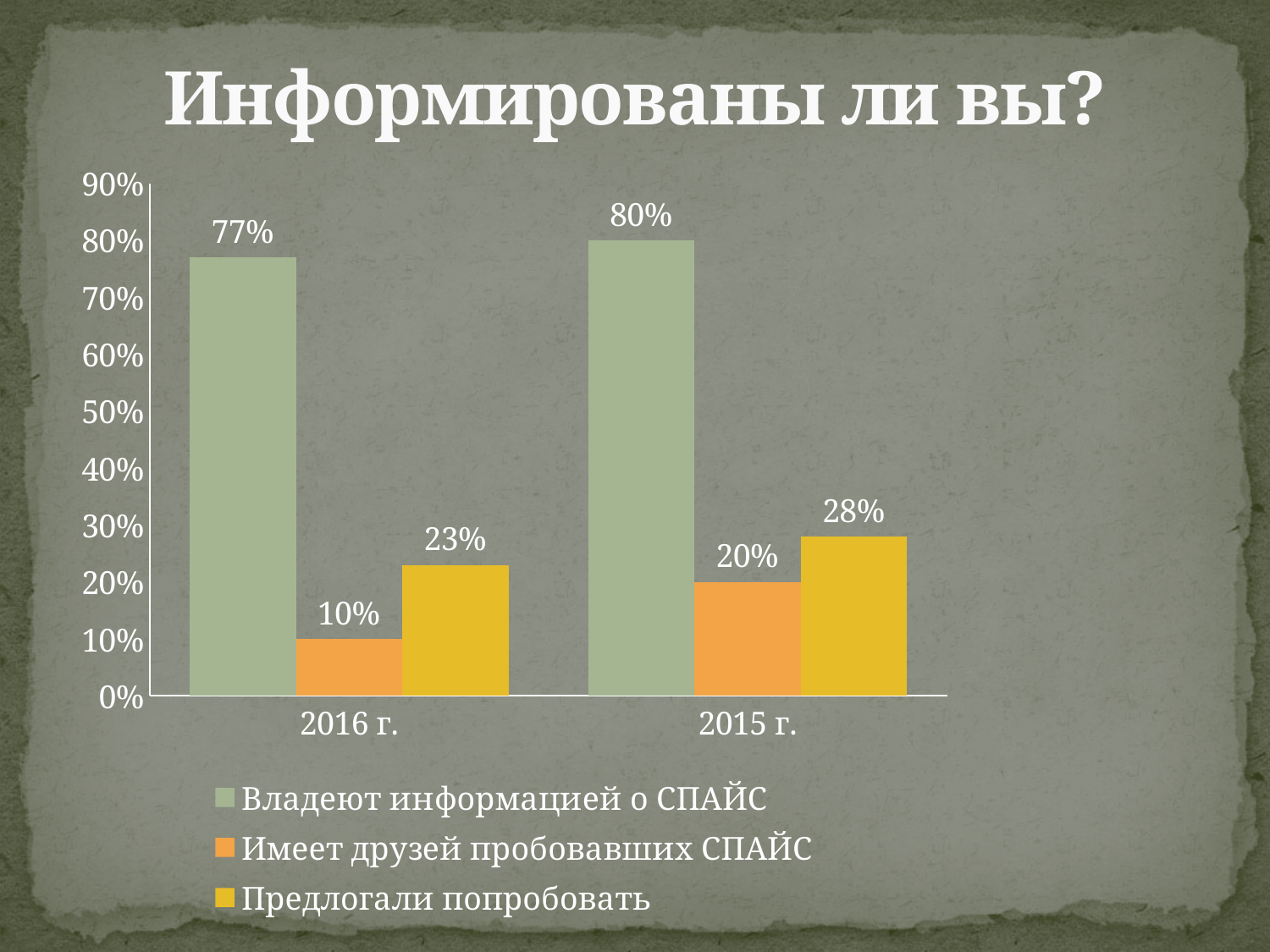
Is the value for "Владеют информацией о СПАЙС" in 2015 г. greater or less than 70%? greater What is the value for "Владеют информацией о СПАЙС" in 2016 г.? 77% How many categories are shown on the x axis? 2 What is the value for "Имеет друзей пробовавших СПАЙС" in 2015 г.? 20% What is the value for "Предлогали попробовать" in 2016 г.? 23% Which series has the highest value in 2015 г.? Владеют информацией о СПАЙС What is the title of the slide? Информированы ли вы? Which year has the larger value for "Имеет друзей пробовавших СПАЙС", 2016 г. or 2015 г.? 2015 г. Which series has the lowest value in 2016 г.? Имеет друзей пробовавших СПАЙС What is the difference between the "Предлогали попробовать" values for 2015 г. and 2016 г.? 5% What kind of chart is shown on the slide? bar chart How many series does the legend list? 3